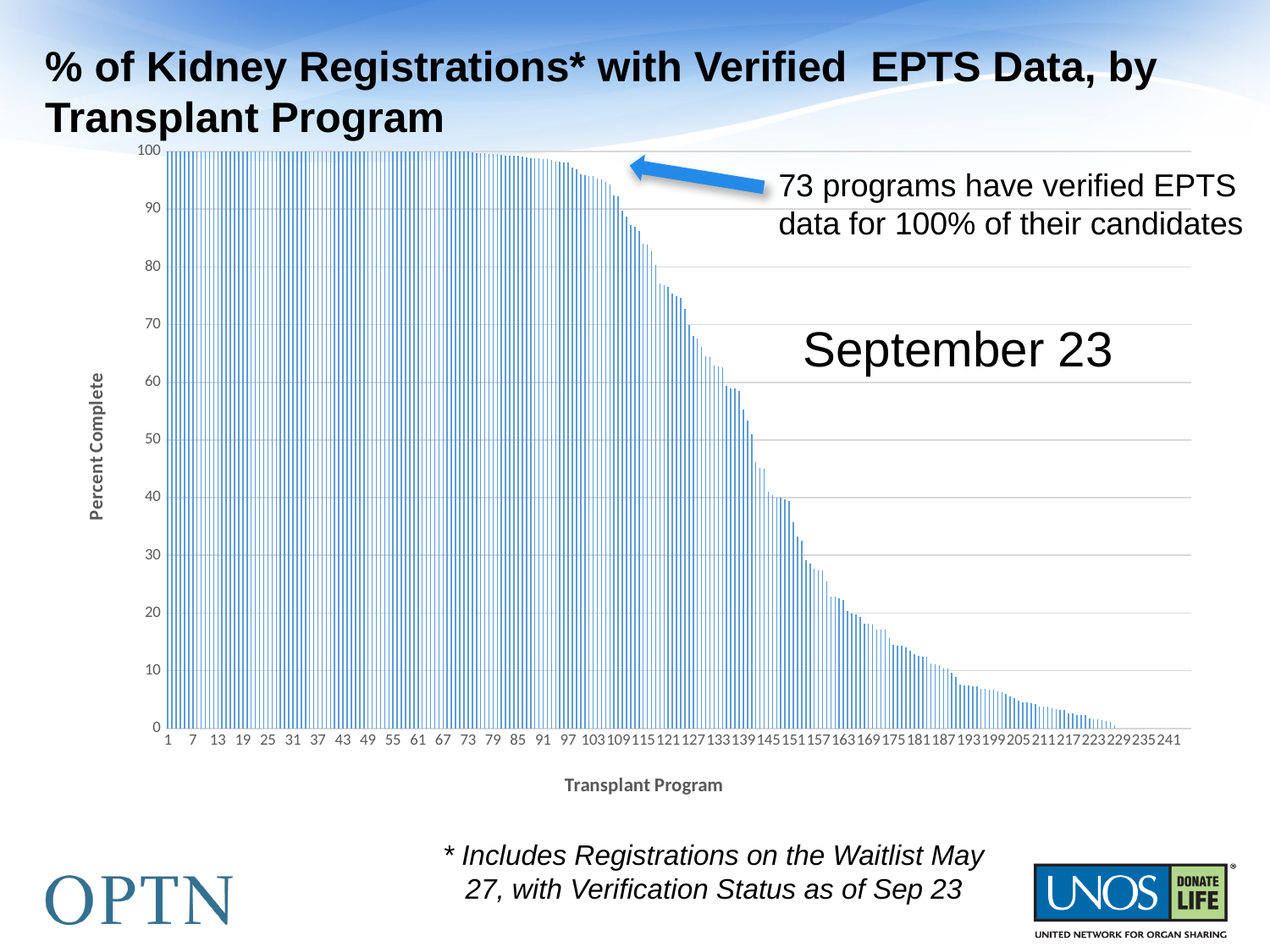
According to the slide, how many programs have verified EPTS data for 100% of their candidates? 73 Do the values rise or fall as you move from left to right along the x axis (Transplant Program)? fall Is the value for transplant program 103 greater or less than 90? greater Is the value for transplant program 133 greater or less than 50? greater Is the value for transplant program 175 greater or less than 20? less What is the label on the x axis of the chart? Transplant Program What is the label on the y axis of the chart? Percent Complete What is the highest value reached by any bar on the chart? 100 Which has the larger value, transplant program 1 or transplant program 199? transplant program 1 What kind of chart is shown on the slide? bar chart